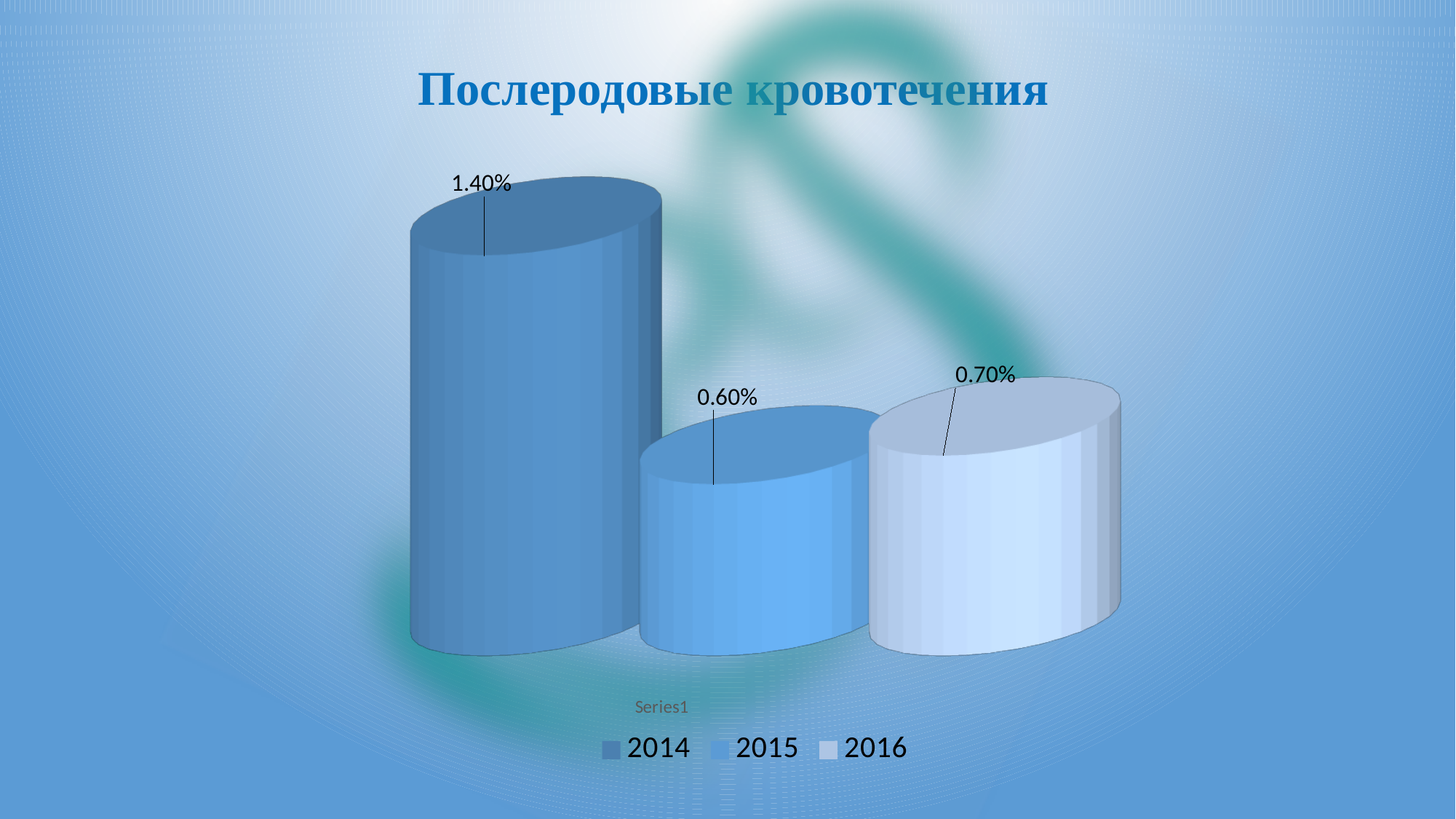
What is the value for 2014? 1.40% How many series does the legend list? 3 What is the title of the chart? Послеродовые кровотечения What is the value for 2015? 0.60% What is the difference between the values for 2016 and 2015? 0.10% Which is larger, the value for 2014 or the value for 2016? 2014 What is the value for 2016? 0.70% What kind of chart is shown on the slide? Bar chart Which year has the lowest value? 2015 Which year has the highest value? 2014 What is the difference between the values for 2014 and 2015? 0.80% What is the category label shown below the bars? Series1